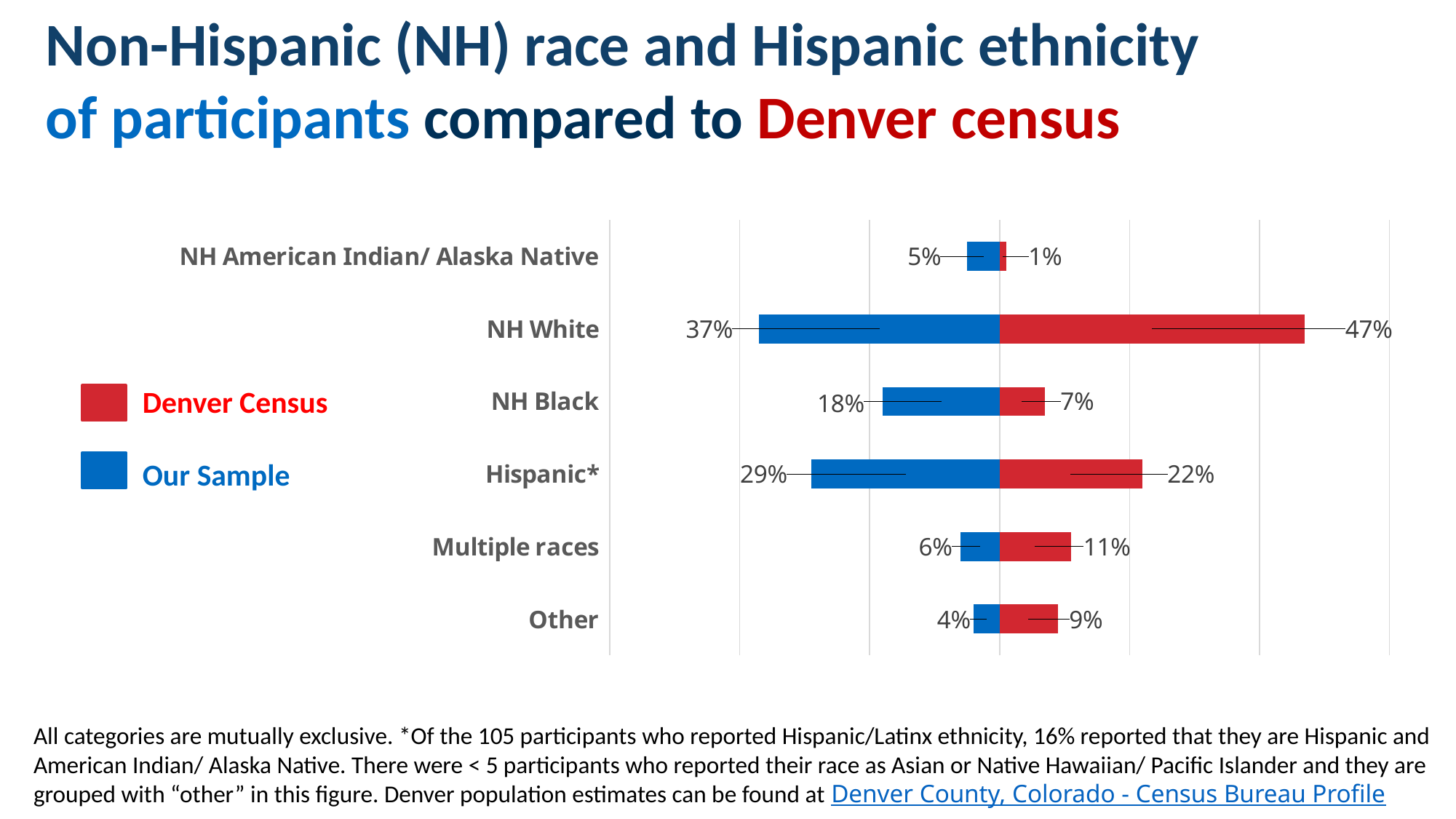
What is the Denver Census value for NH American Indian/ Alaska Native? 1% What is the Denver Census value for Hispanic*? 22% How many series does the legend list? 2 Which colour represents Our Sample in the legend? Blue What is the difference between the Denver Census and Our Sample values for NH Black? 11% How many categories are shown on the chart? 6 What is the Our Sample value for Multiple races? 6% What kind of chart is shown on the slide? Bar chart What is the Our Sample value for NH White? 37% Which category has the lowest Our Sample value? Other Which category has the highest Denver Census value? NH White Which is larger for Other: the Denver Census value or the Our Sample value? Denver Census